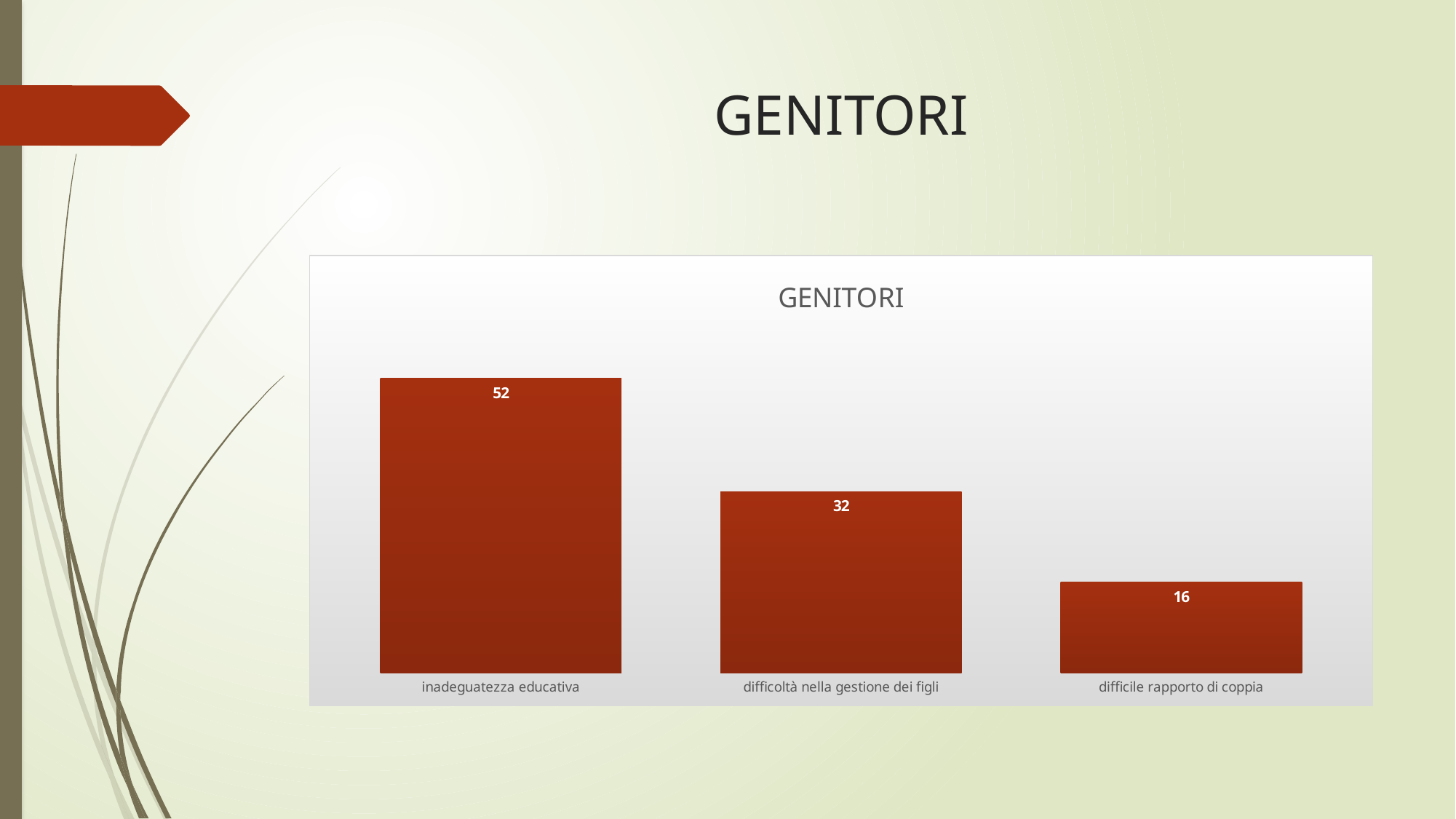
What is the difference between the values for "difficoltà nella gestione dei figli" and "difficile rapporto di coppia"? 16 What is the value for "difficile rapporto di coppia"? 16 Which category has the lowest value? difficile rapporto di coppia How many categories are shown in the chart? 3 What is the value for "inadeguatezza educativa"? 52 Which is larger: the value for "difficoltà nella gestione dei figli" or the value for "difficile rapporto di coppia"? difficoltà nella gestione dei figli What is the value for "difficoltà nella gestione dei figli"? 32 What is the title of the chart? GENITORI What is the difference between the values for "inadeguatezza educativa" and "difficoltà nella gestione dei figli"? 20 What kind of chart is shown on the slide? bar chart Do the values rise or fall from left to right across the categories? fall Which category has the highest value? inadeguatezza educativa